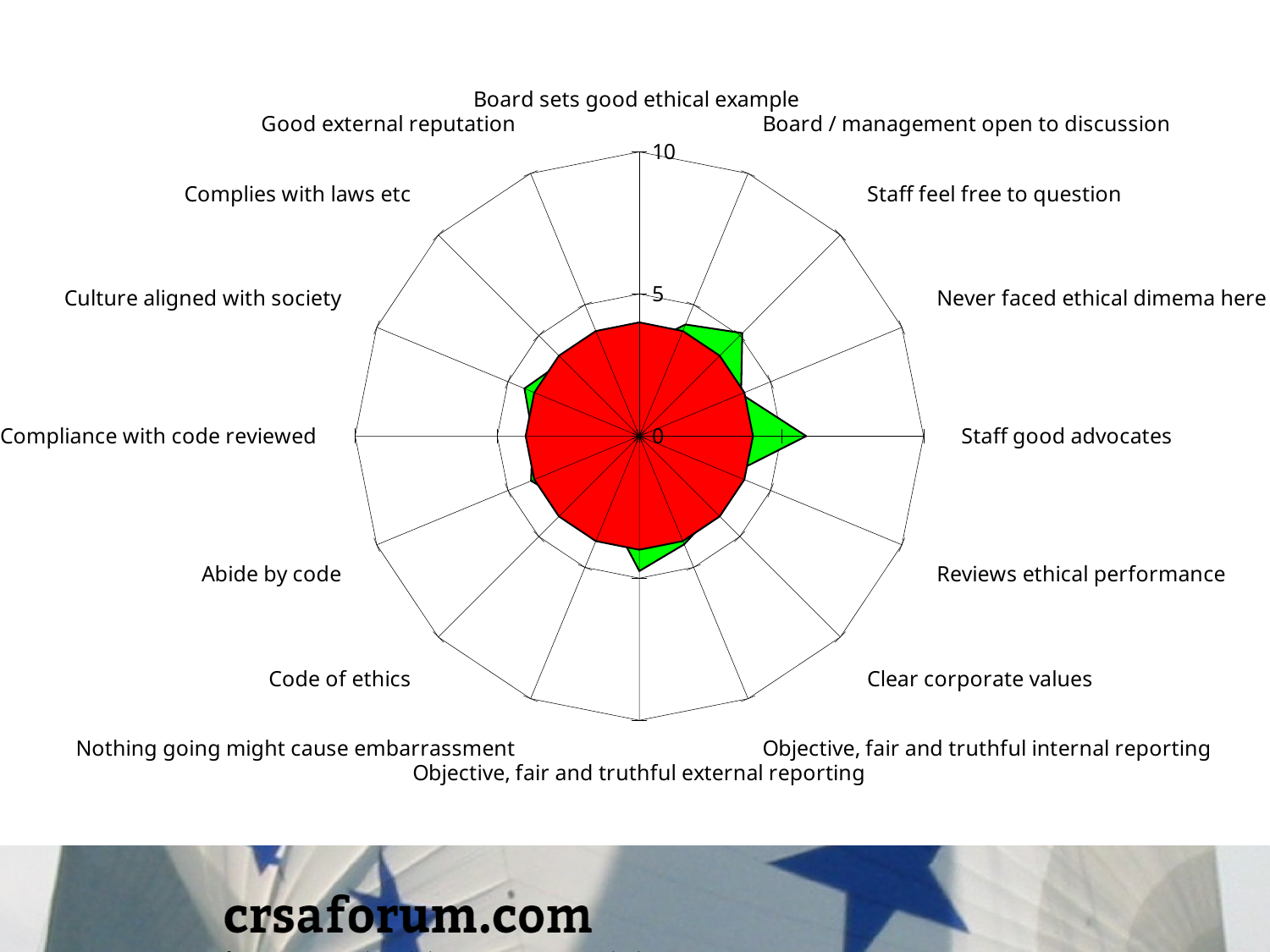
For which category does the green series reach its highest value? Staff good advocates What two colours are used for the plotted series on the radar chart? red and green What is the highest value shown on the radar chart's axis? 10 Is the green series value for Staff good advocates greater or less than 10? less Is the red series value for Code of ethics greater or less than 5? less Is the green series value for Staff good advocates greater or less than 5? greater What kind of chart is shown on the slide? radar chart How many categories are plotted around the radar chart? 16 Which is larger for Staff good advocates, the green series value or the red series value? green series